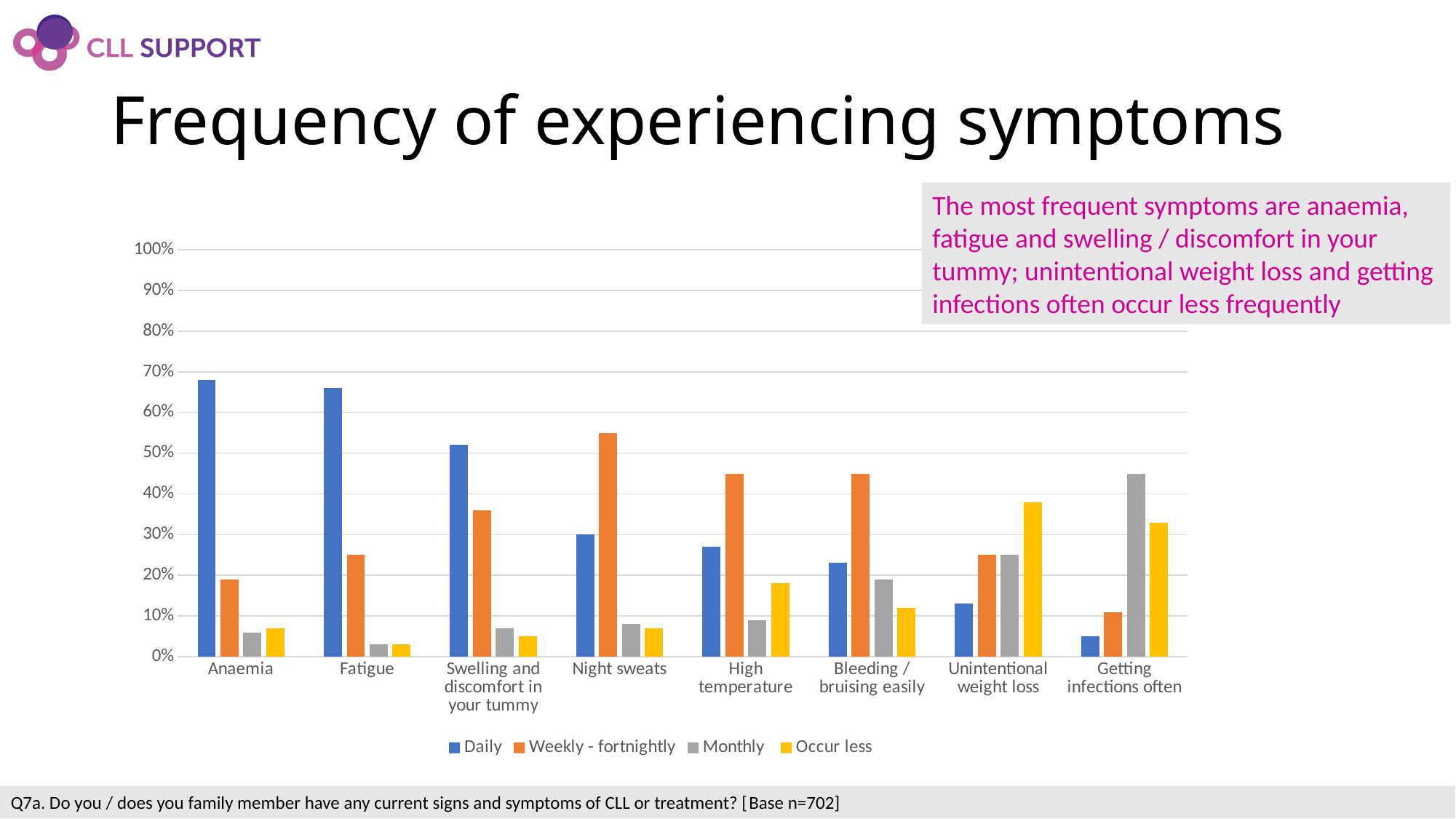
Does the Daily series rise or fall moving from Anaemia to Getting infections often along the x axis? Falls How many symptom categories are shown on the x axis? 8 What kind of chart is shown on the slide? Bar chart What is the title of the chart on the slide? Frequency of experiencing symptoms How many series does the legend list? 4 Is the Monthly value for Fatigue greater or less than 10%? less For Unintentional weight loss, which is larger: the Daily value or the Occur less value? Occur less Which symptom has the highest Weekly - fortnightly value? Night sweats Which symptom has the lowest Daily value? Getting infections often Is the Daily value for Anaemia greater or less than 60%? greater Which symptom has the highest Monthly value? Getting infections often Is the Weekly - fortnightly value for Night sweats greater or less than 50%? greater